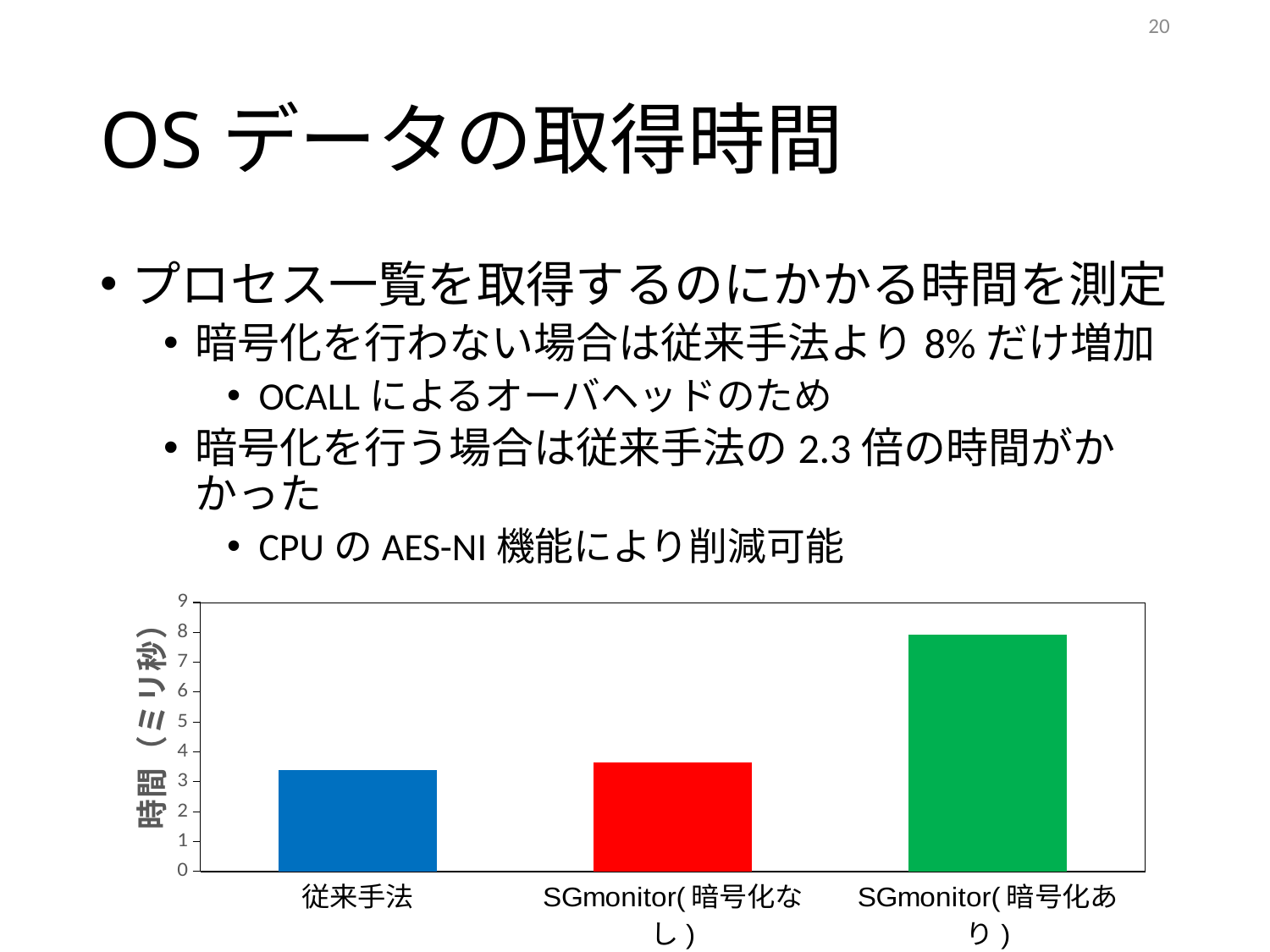
What colour is the bar for SGmonitor(暗号化あり)? green How many bars (categories) are plotted in the chart? 3 Is the value for SGmonitor(暗号化あり) greater or less than 7? greater Is the value for SGmonitor(暗号化なし) greater or less than 4? less Is the value for 従来手法 greater or less than 3? greater Which is larger, the value for 従来手法 or the value for SGmonitor(暗号化あり)? SGmonitor(暗号化あり) What is the label of the vertical axis of the chart? 時間（ミリ秒） Do the bar values rise or fall from left to right across the categories? rise What kind of chart is shown on the slide? bar chart Which category has the highest value in the chart? SGmonitor(暗号化あり)